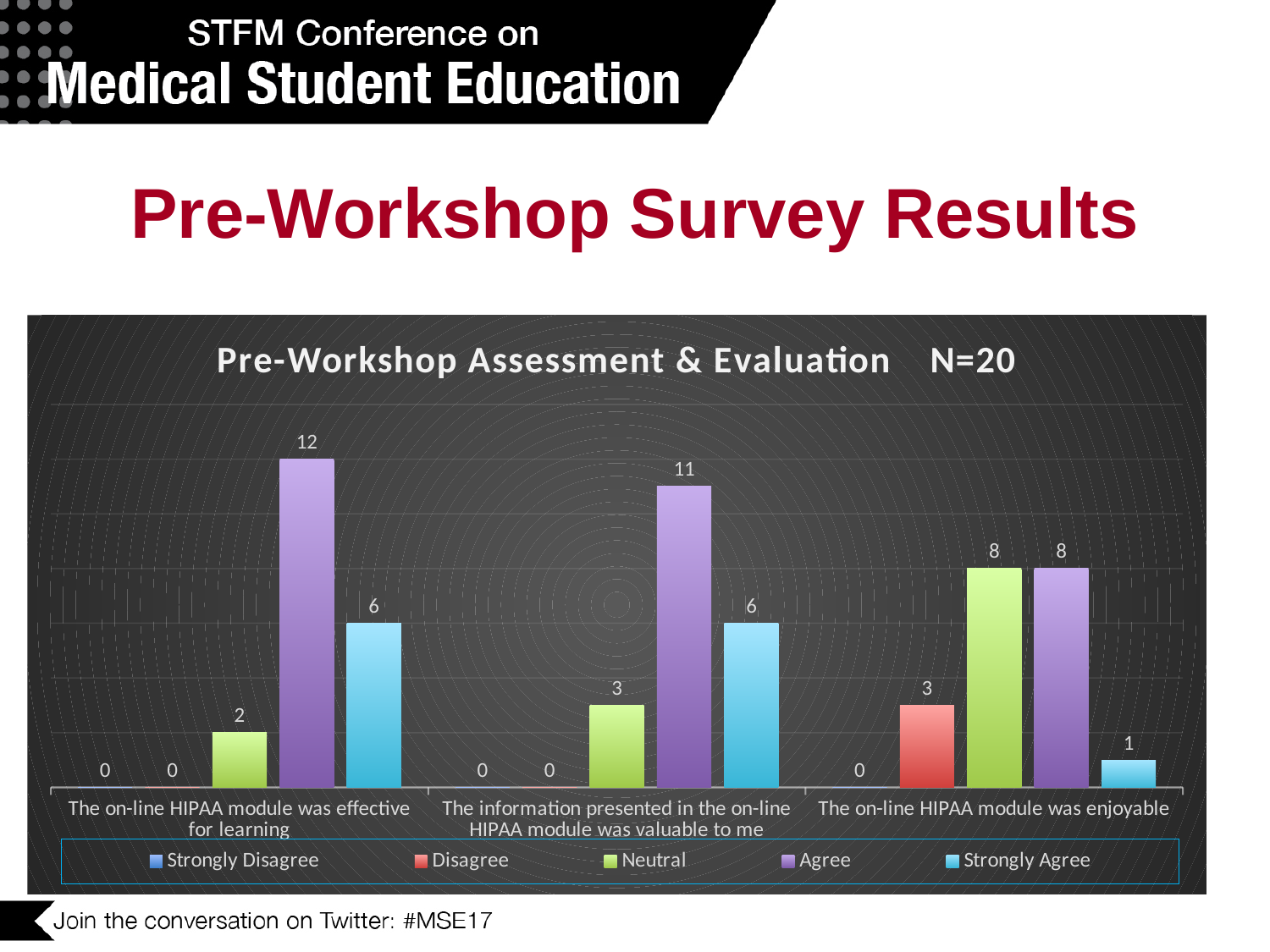
What is the difference between the Agree and Strongly Agree values for the statement 'The on-line HIPAA module was effective for learning'? 6 What is the value for Strongly Agree for the statement 'The on-line HIPAA module was enjoyable'? 1 What kind of chart is shown on the slide? Bar chart What is the value for Disagree for the statement 'The on-line HIPAA module was enjoyable'? 3 How many series does the legend list? 5 What is the value for Agree for the statement 'The on-line HIPAA module was effective for learning'? 12 Which is larger for the statement 'The on-line HIPAA module was enjoyable': Disagree or Neutral? Neutral What is the difference between the Agree values for 'The on-line HIPAA module was effective for learning' and 'The on-line HIPAA module was enjoyable'? 4 Which response category has the highest value for the statement 'The information presented in the on-line HIPAA module was valuable to me'? Agree What is the value for Neutral for the statement 'The information presented in the on-line HIPAA module was valuable to me'? 3 How many statements (categories) are shown on the x axis? 3 What is the title of the chart? Pre-Workshop Assessment & Evaluation N=20